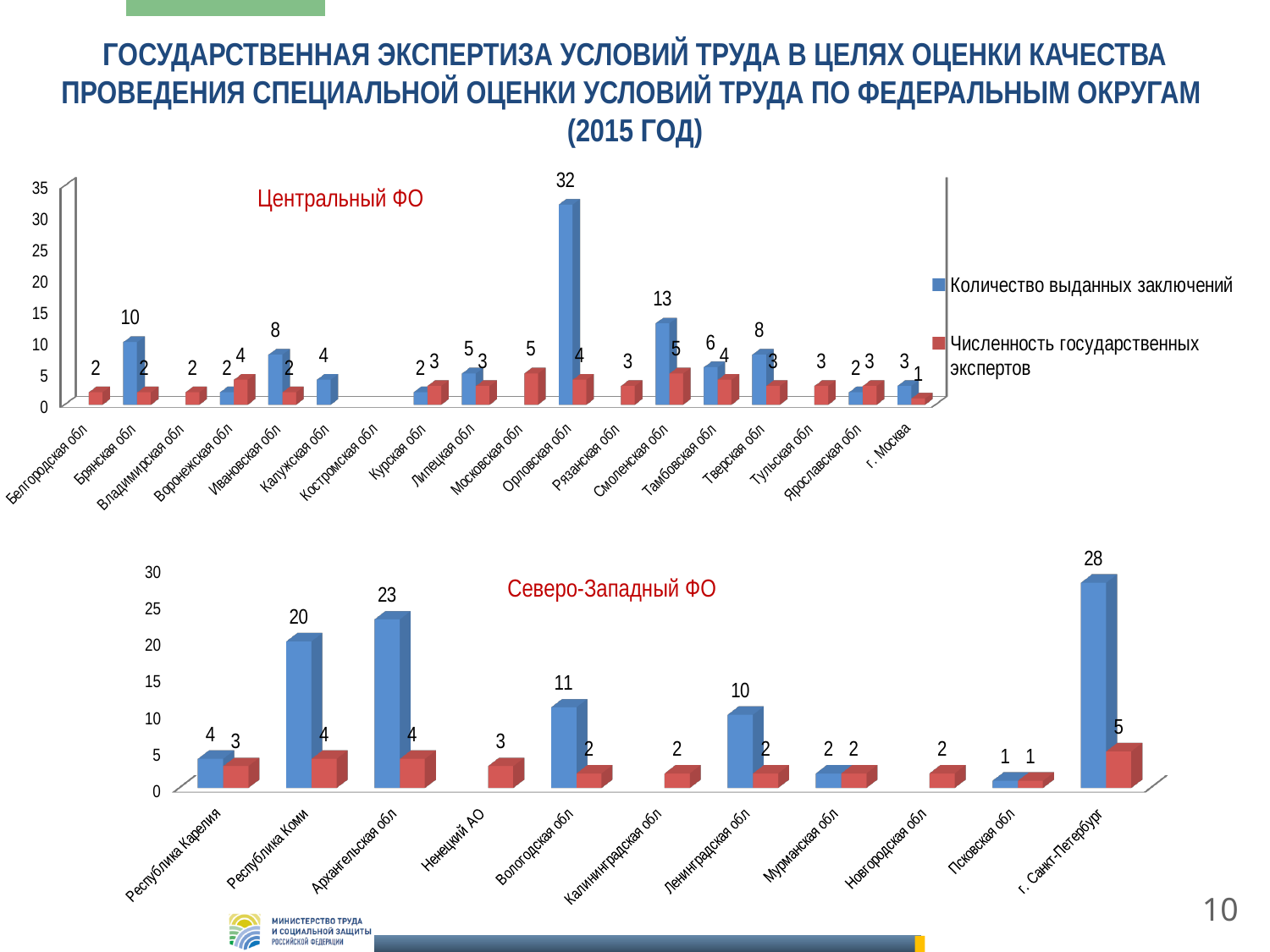
In the Центральный ФО chart, how many выданных заключений are shown for Орловская обл? 32 In the Центральный ФО chart, what is the Численность государственных экспертов for Смоленская обл? 5 How many series does the legend list? 2 How many regions are shown on the x axis of the Северо-Западный ФО chart? 11 In the Центральный ФО chart, which is larger for Брянская обл: Количество выданных заключений or Численность государственных экспертов? Количество выданных заключений In the Центральный ФО chart, which region has the highest Количество выданных заключений? Орловская обл What type of chart is the Северо-Западный ФО chart? Bar chart In the Северо-Западный ФО chart, what is the Численность государственных экспертов for Ненецкий АО? 3 In the Северо-Западный ФО chart, which region has the highest Количество выданных заключений? г. Санкт-Петербург In the Северо-Западный ФО chart, what is the difference between Количество выданных заключений for Архангельская обл and Республика Коми? 3 In the Северо-Западный ФО chart, what is the Количество выданных заключений for г. Санкт-Петербург? 28 In the Центральный ФО chart, what is the difference between Количество выданных заключений for Орловская обл and Смоленская обл? 19